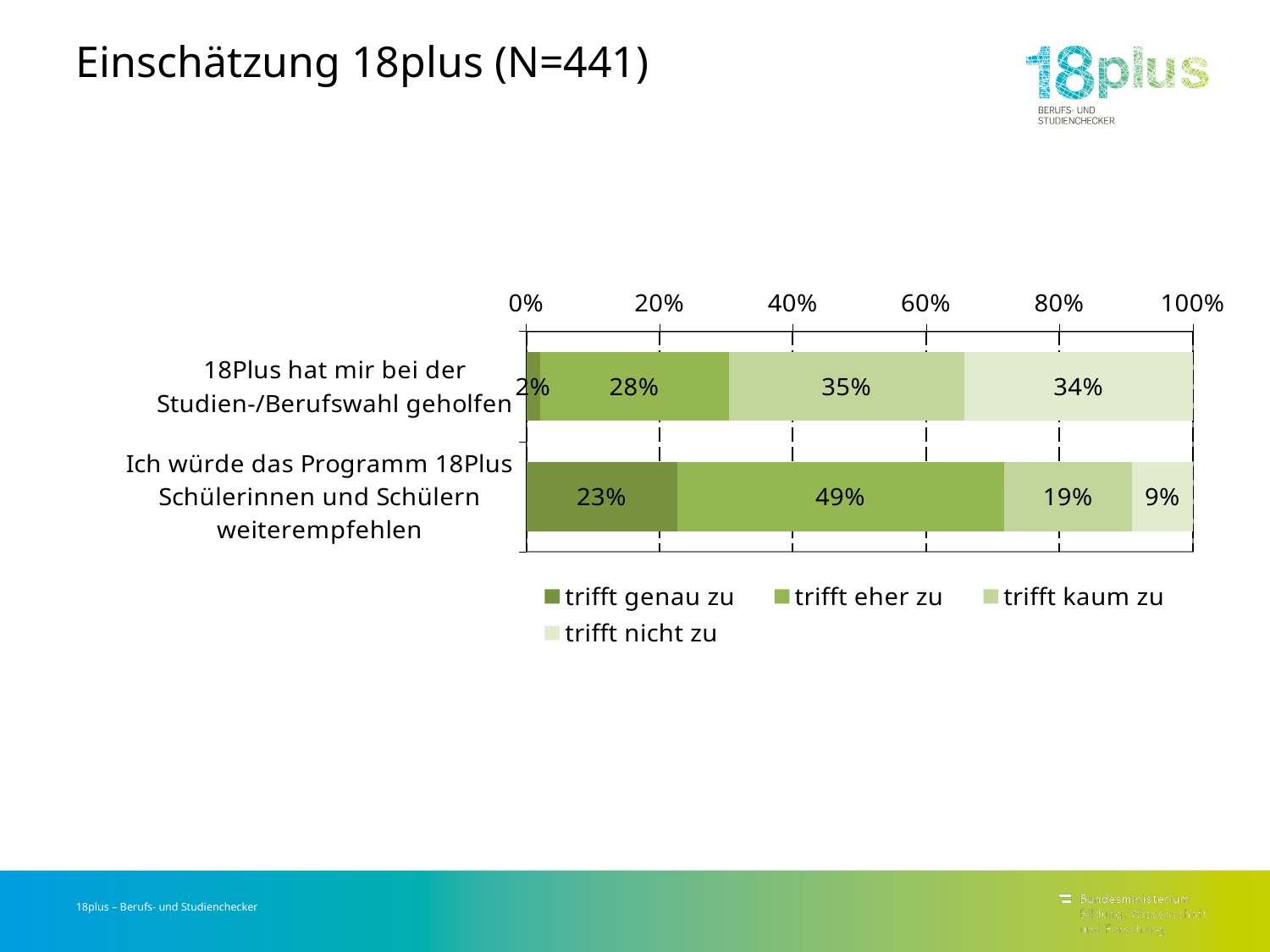
What kind of chart is shown on the slide? Stacked bar chart What is the combined share of "trifft genau zu" and "trifft eher zu" for "Ich würde das Programm 18Plus Schülerinnen und Schülern weiterempfehlen"? 72% What percentage answered "trifft eher zu" for "Ich würde das Programm 18Plus Schülerinnen und Schülern weiterempfehlen"? 49% What percentage answered "trifft kaum zu" for "18Plus hat mir bei der Studien-/Berufswahl geholfen"? 35% How many statements (categories) are shown in the chart? 2 What is the difference between the "trifft eher zu" shares of the two statements? 21 percentage points Which response category has the smallest share for "Ich würde das Programm 18Plus Schülerinnen und Schülern weiterempfehlen"? trifft nicht zu How many series does the legend list? 4 What percentage of respondents answered "trifft genau zu" for "Ich würde das Programm 18Plus Schülerinnen und Schülern weiterempfehlen"? 23% Which response category has the largest share for "18Plus hat mir bei der Studien-/Berufswahl geholfen"? trifft kaum zu Which statement has the larger "trifft genau zu" share? Ich würde das Programm 18Plus Schülerinnen und Schülern weiterempfehlen What percentage answered "trifft nicht zu" for "18Plus hat mir bei der Studien-/Berufswahl geholfen"? 34%